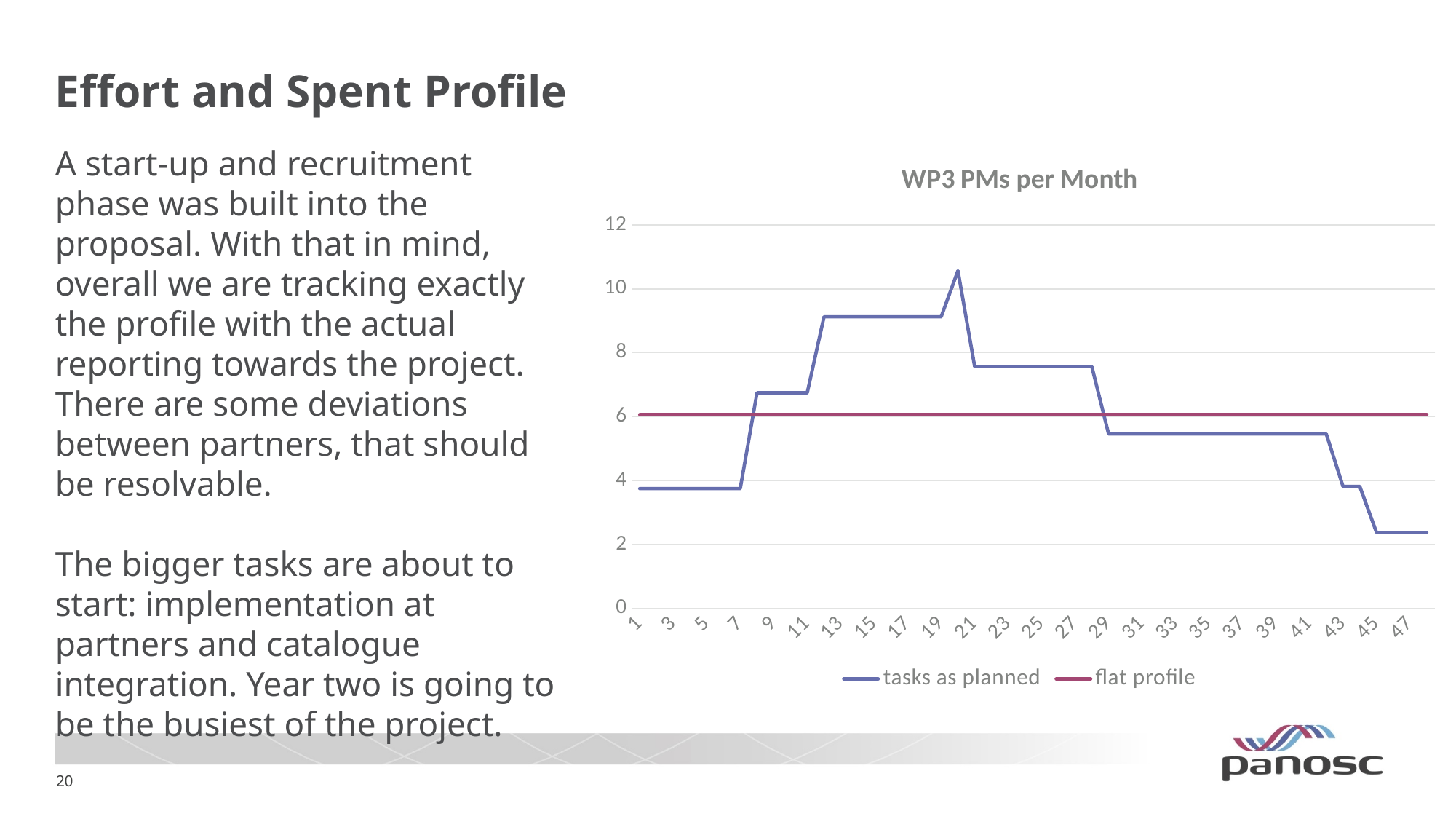
At month 10, which series has the higher value, tasks as planned or flat profile? tasks as planned How many series does the chart legend list? 2 Is the value of tasks as planned at month 15 greater or less than 8? greater At month 40, which series has the higher value, tasks as planned or flat profile? flat profile What kind of chart is shown on the slide? line chart Is the value of tasks as planned at month 45 greater or less than 4? less What are the two series named in the chart legend? tasks as planned and flat profile Is the value of tasks as planned at month 1 greater or less than 4? less Does the tasks as planned series rise or fall from month 29 to month 47? fall What is the title of the chart? WP3 PMs per Month